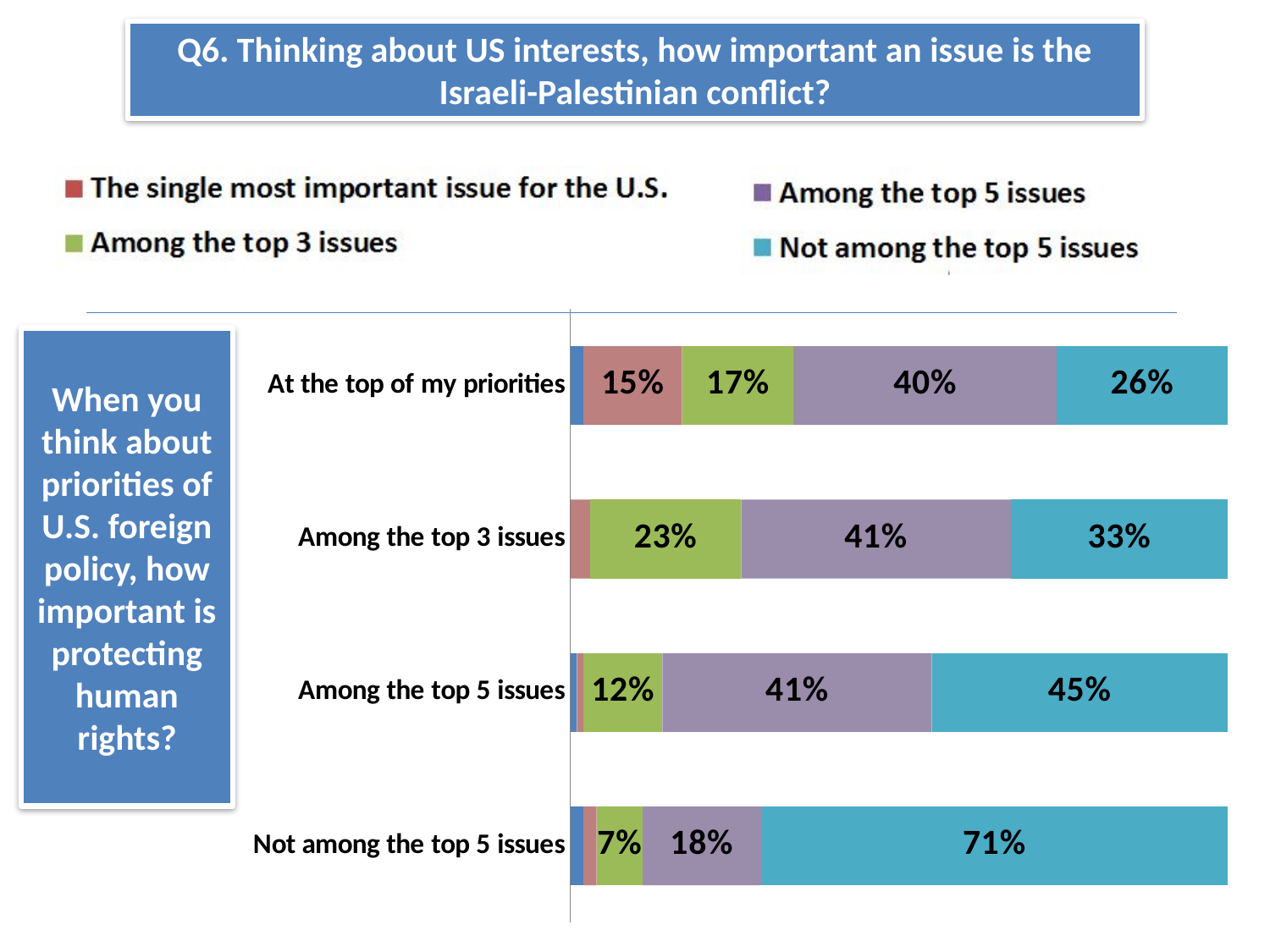
What percentage of respondents who rate human rights 'At the top of my priorities' say the Israeli-Palestinian conflict is the single most important issue for the U.S.? 15% What colour represents 'Not among the top 5 issues' in the legend? Teal/blue How many categories (rows) are plotted in the chart? 4 What is the difference between the 'Not among the top 5 issues' values for the 'Among the top 5 issues' row (45%) and the 'Among the top 3 issues' row (33%)? 12% What kind of chart is shown on the slide? Stacked bar chart What is the 'Not among the top 5 issues' value for the 'Not among the top 5 issues' row? 71% How many entries does the legend list? 4 What is the 'Among the top 3 issues' value for the 'Among the top 3 issues' row? 23% Which row has the highest 'Not among the top 5 issues' value? Not among the top 5 issues What is the 'Among the top 5 issues' value for the 'At the top of my priorities' row? 40% Which row has the lowest 'Not among the top 5 issues' value? At the top of my priorities Which is larger: the 'Among the top 3 issues' value for the 'At the top of my priorities' row or for the 'Among the top 5 issues' row? At the top of my priorities